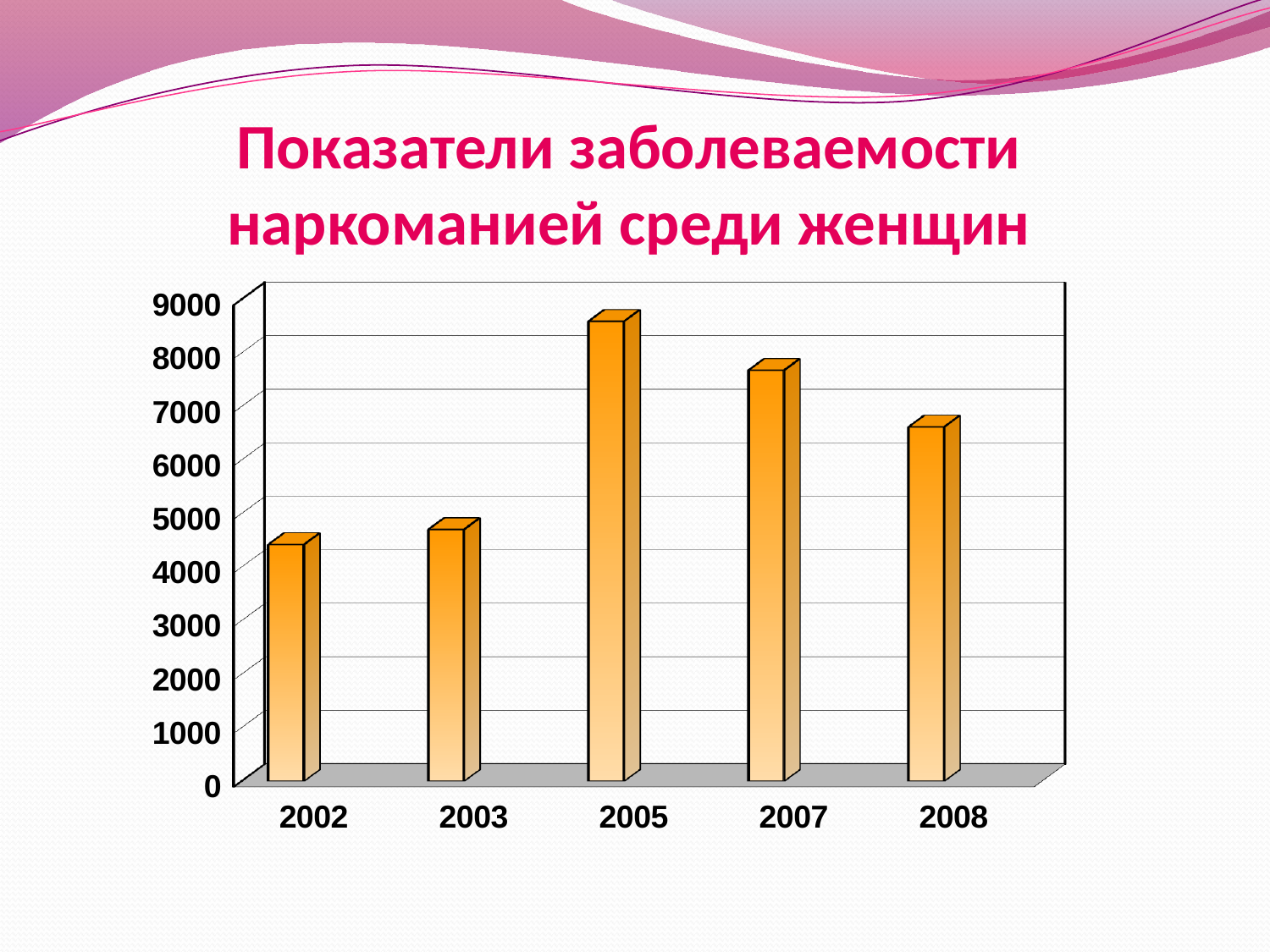
Which is larger, the value for 2008 or the value for 2002? 2008 Is the value for 2007 greater or less than 7000? greater Do the values rise or fall from 2005 to 2008? fall Is the value for 2008 greater or less than 6000? greater How many years are shown on the x axis of the chart? 5 Is the value for 2003 greater or less than 6000? less Which year has the highest value in the chart? 2005 What kind of chart is shown on the slide? bar chart What is the title of the chart on the slide? Показатели заболеваемости наркоманией среди женщин Which is larger, the value for 2005 or the value for 2007? 2005